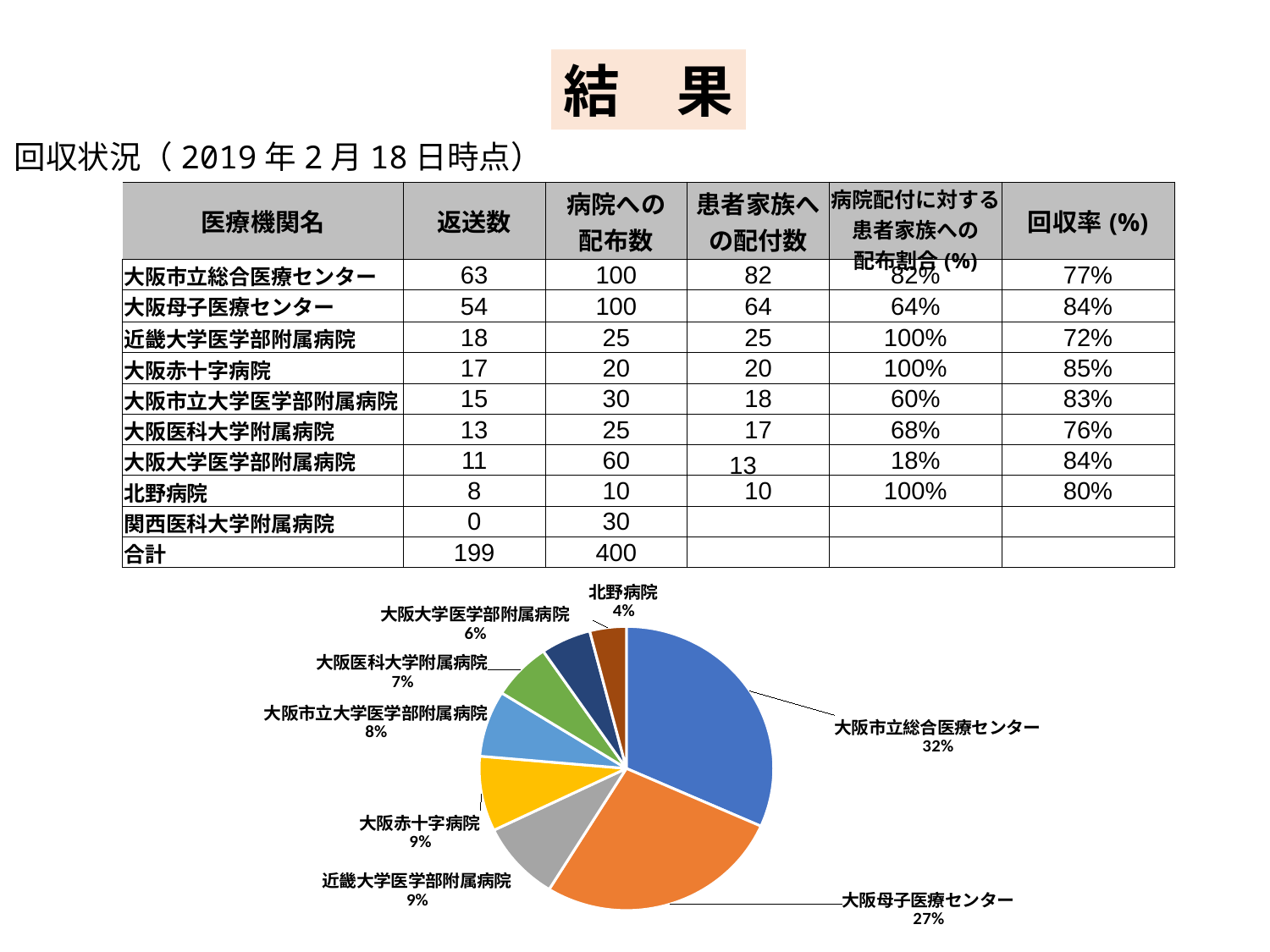
Which hospital has the largest slice in the pie chart? 大阪市立総合医療センター Which slice is larger in the pie chart, 大阪大学医学部附属病院 or 大阪赤十字病院? 大阪赤十字病院 What is the difference in percentage points between the slices for 大阪市立総合医療センター and 大阪母子医療センター? 5% What share of the pie chart does 大阪市立総合医療センター have? 32% What share of the pie chart does 大阪母子医療センター have? 27% Which hospital has the smallest slice in the pie chart? 北野病院 What kind of chart is shown on the slide? pie chart What share of the pie chart does 北野病院 have? 4% What colour is the slice for 大阪母子医療センター in the pie chart? orange How many slices does the pie chart have? 8